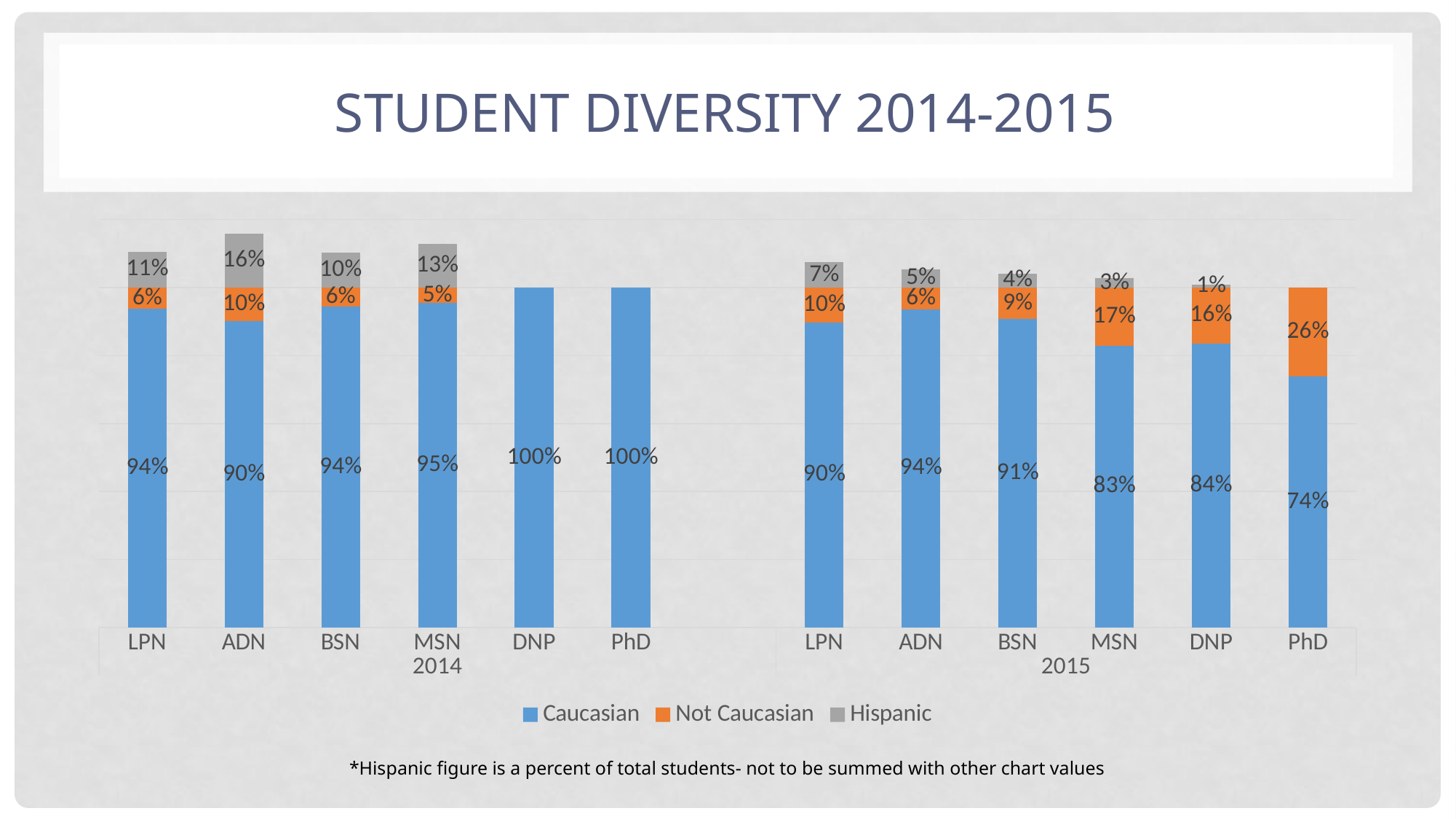
Which program in 2015 has the highest Not Caucasian percentage? PhD Which is larger, the Hispanic percentage for LPN in 2014 or LPN in 2015? LPN in 2014 What is the difference between the Caucasian percentage for MSN in 2014 and MSN in 2015? 12% How many series does the legend list? 3 Is the Caucasian percentage for DNP in 2015 larger than for DNP in 2014? No What is the title of the chart? STUDENT DIVERSITY 2014-2015 What is the Hispanic percentage for ADN in 2014? 16% What is the Caucasian percentage for PhD in 2015? 74% Which program in 2014 has the highest Hispanic percentage? ADN What kind of chart is shown on the slide? Stacked bar chart Which program in 2015 has the lowest Caucasian percentage? PhD What is the Not Caucasian percentage for MSN in 2015? 17%